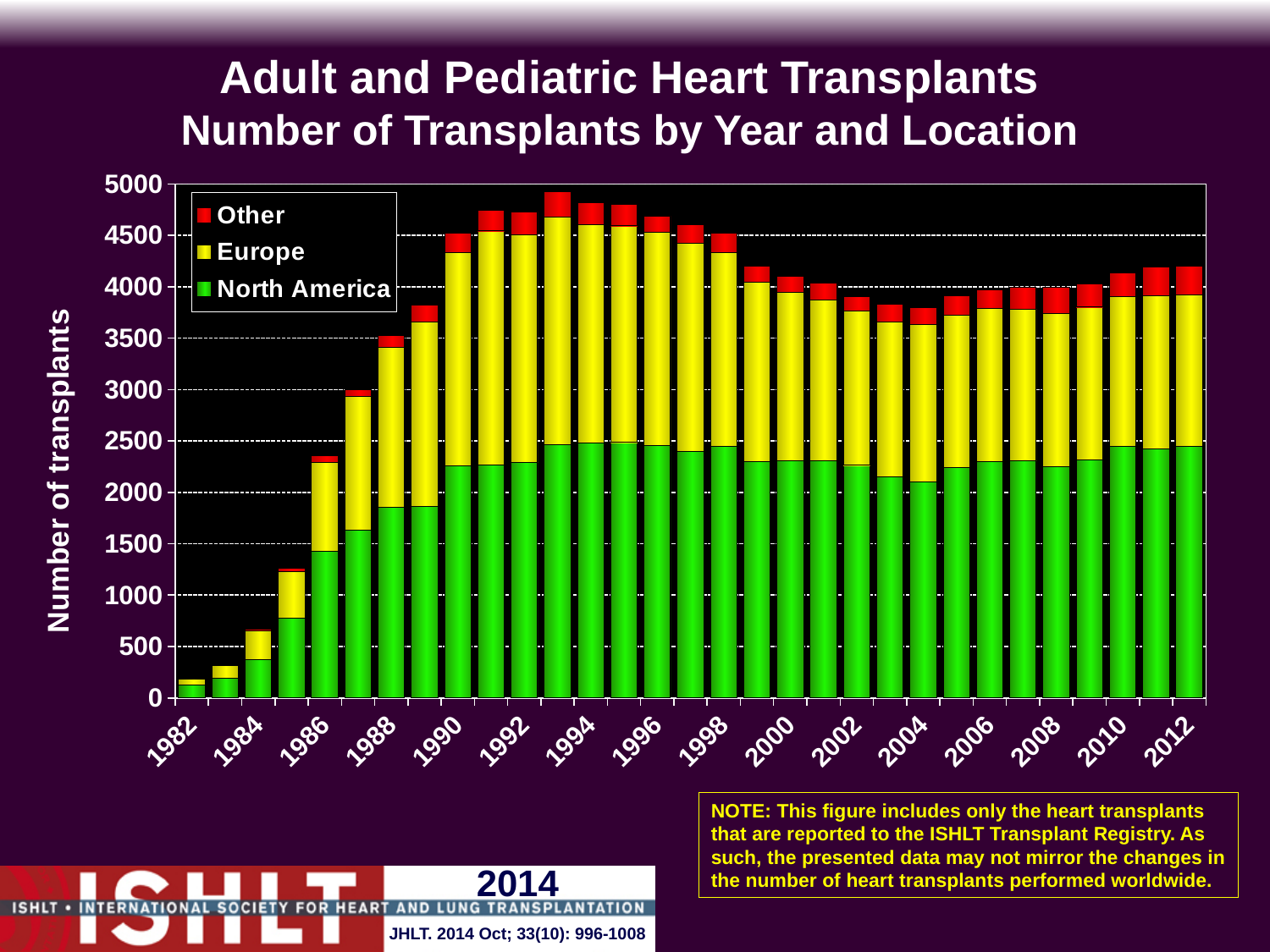
Do the total number of transplants rise or fall from 1982 to 1994? rise What kind of chart is shown on the slide? stacked bar chart Which year has the highest total number of transplants? 1993 What colour represents North America in the chart? green Which series are listed in the legend? Other, Europe, North America How many series does the legend list? 3 Is the total number of transplants in 1982 greater or less than 500? less Is the number of North America transplants in 1994 greater or less than 2000? greater Is the total number of transplants in 1994 greater or less than 4500? greater How many years (bars) are plotted in the chart? 31 Which year has the lowest total number of transplants? 1982 Which year has a larger total number of transplants, 1990 or 2000? 1990